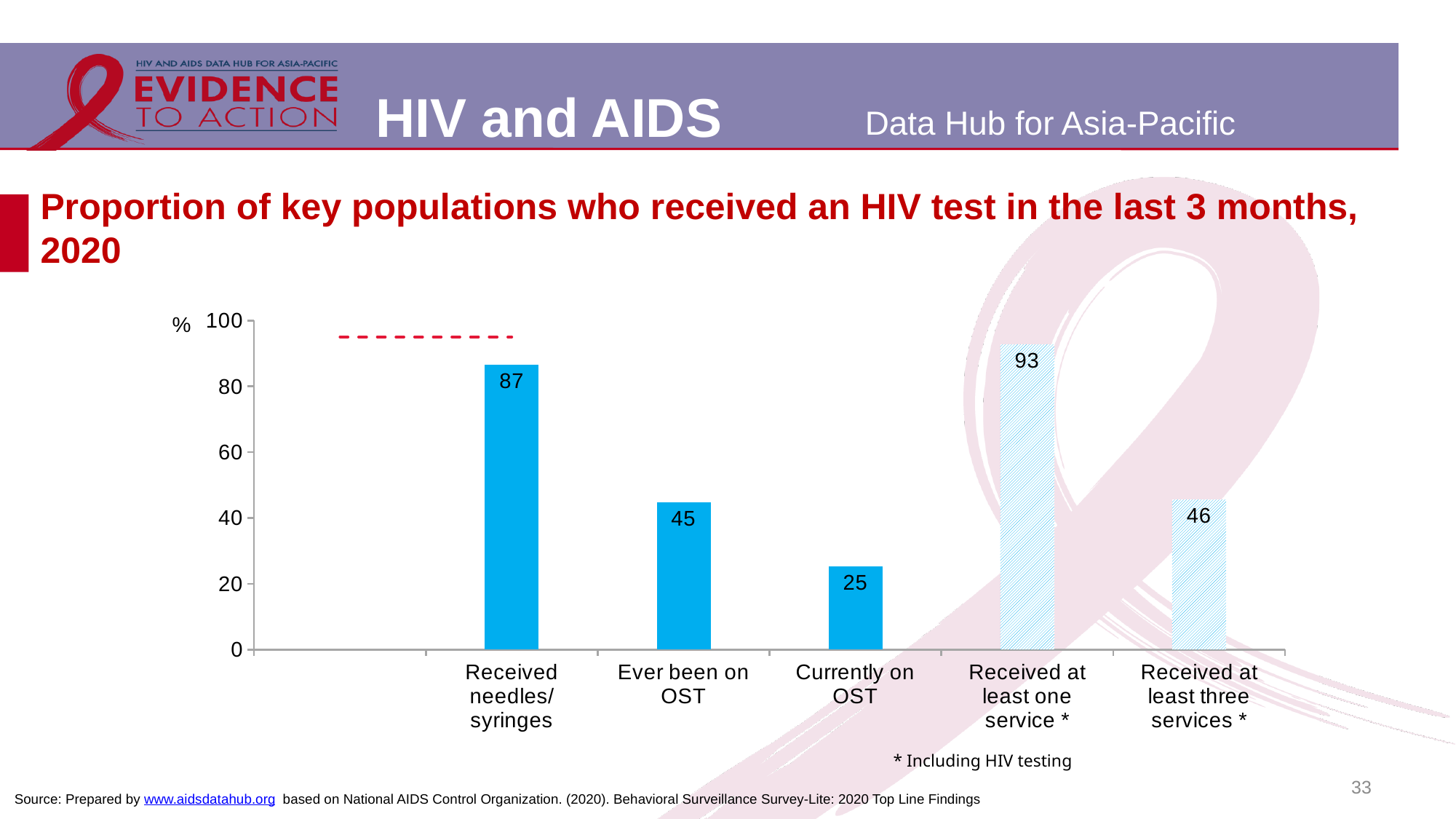
What is the value for 'Received at least three services *'? 46 Which category has the lowest value? Currently on OST What is the value for 'Received needles/ syringes'? 87 How many categories are shown on the x axis? 5 What does the asterisk (*) in the category labels indicate, according to the note below the chart? Including HIV testing What is the value for 'Received at least one service *'? 93 Which category has the highest value? Received at least one service * What is the value for 'Currently on OST'? 25 Which is larger, the value for 'Received needles/ syringes' or the value for 'Ever been on OST'? Received needles/ syringes What is the value for 'Ever been on OST'? 45 What kind of chart is shown on the slide? Bar chart What is the difference between the values for 'Received at least one service *' and 'Received at least three services *'? 47